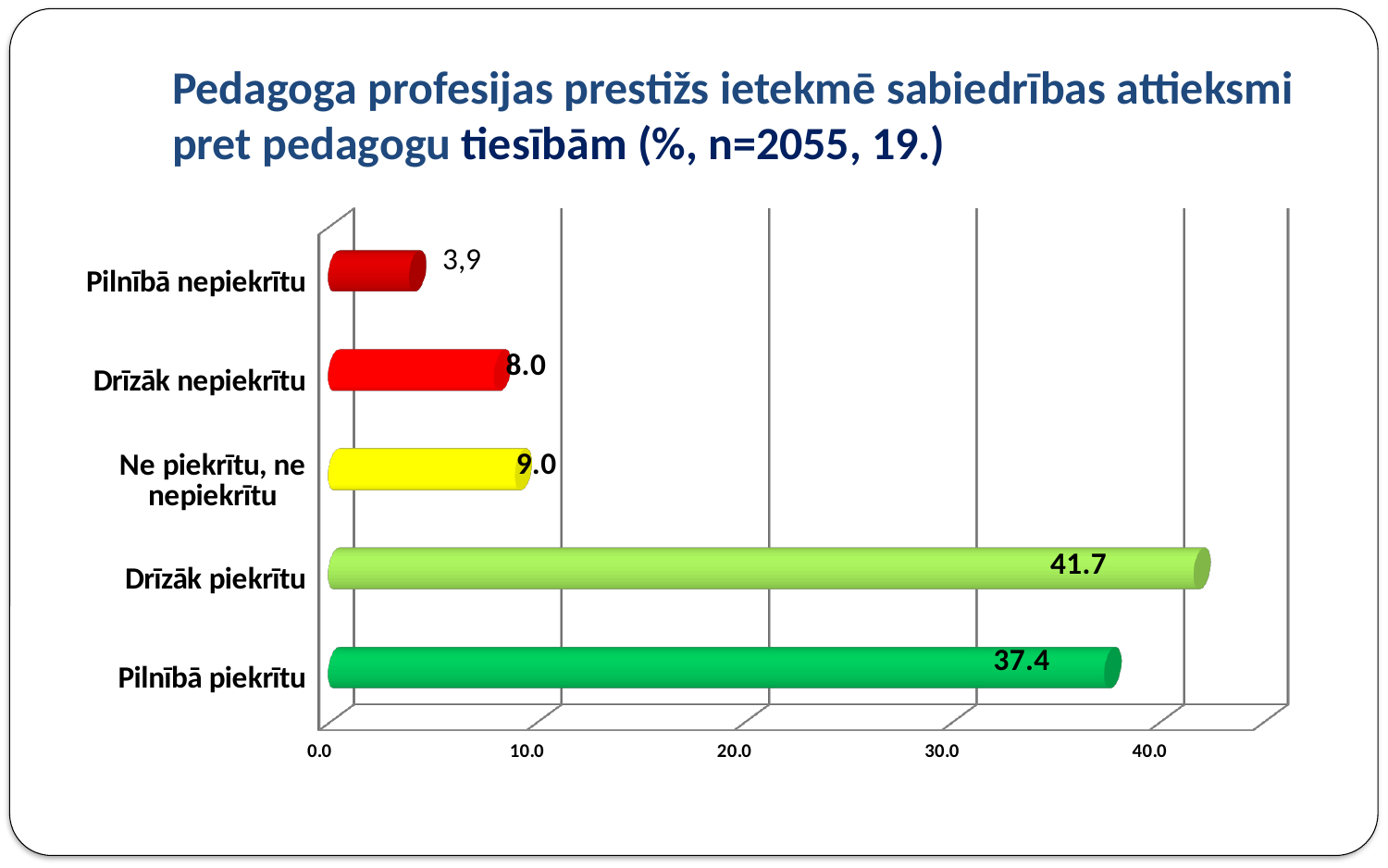
Is the value for "Pilnībā piekrītu" greater or less than 30.0? greater What is the value for "Drīzāk piekrītu"? 41.7 What is the difference between the values for "Drīzāk piekrītu" and "Pilnībā piekrītu"? 4.3 What is the value for "Pilnībā piekrītu"? 37.4 How many categories are shown in the chart? 5 What is the value for "Ne piekrītu, ne nepiekrītu"? 9.0 What is the value for "Pilnībā nepiekrītu"? 3,9 Which category has the highest value? Drīzāk piekrītu Which category has the lowest value? Pilnībā nepiekrītu What kind of chart is shown on the slide? Bar chart What colour is the bar for "Ne piekrītu, ne nepiekrītu"? Yellow Which is larger, the value for "Drīzāk nepiekrītu" or the value for "Ne piekrītu, ne nepiekrītu"? Ne piekrītu, ne nepiekrītu